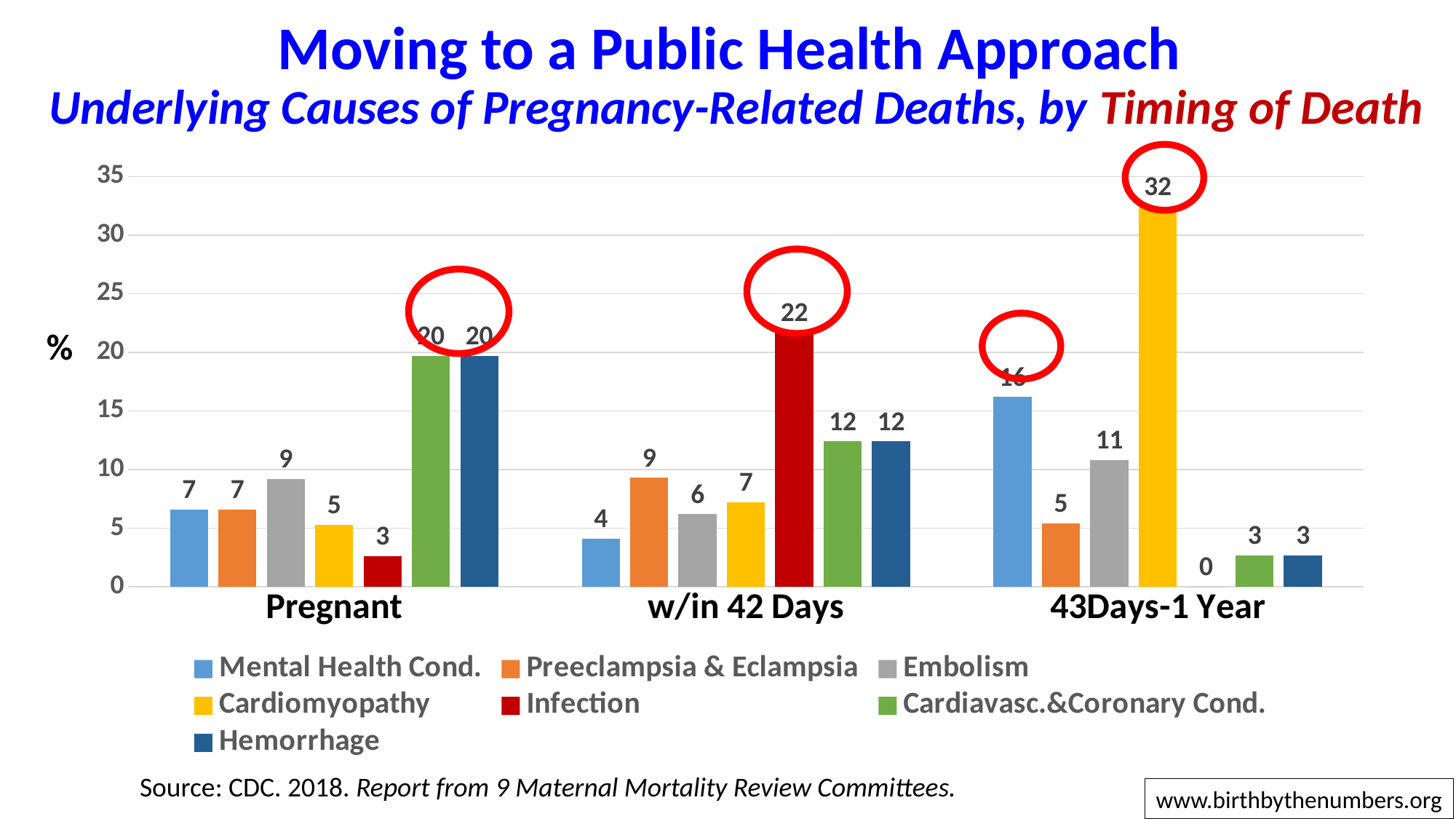
Which is larger: Embolism in Pregnant or Embolism in w/in 42 Days? Embolism in Pregnant What is the value for Cardiomyopathy in the 43Days-1 Year category? 32 What is the value for Hemorrhage in the Pregnant category? 20 What kind of chart is shown on the slide? Bar chart What is the label on the vertical axis? % How many categories are shown on the x axis? 3 What is the value for Mental Health Cond. in the 43Days-1 Year category? 16 Which series has the lowest value in the 43Days-1 Year category? Infection How many series does the legend list? 7 Which series has the highest value in the w/in 42 Days category? Infection What is the difference between the Cardiomyopathy value in 43Days-1 Year and the Cardiomyopathy value in Pregnant? 27 What is the value for Infection in the w/in 42 Days category? 22